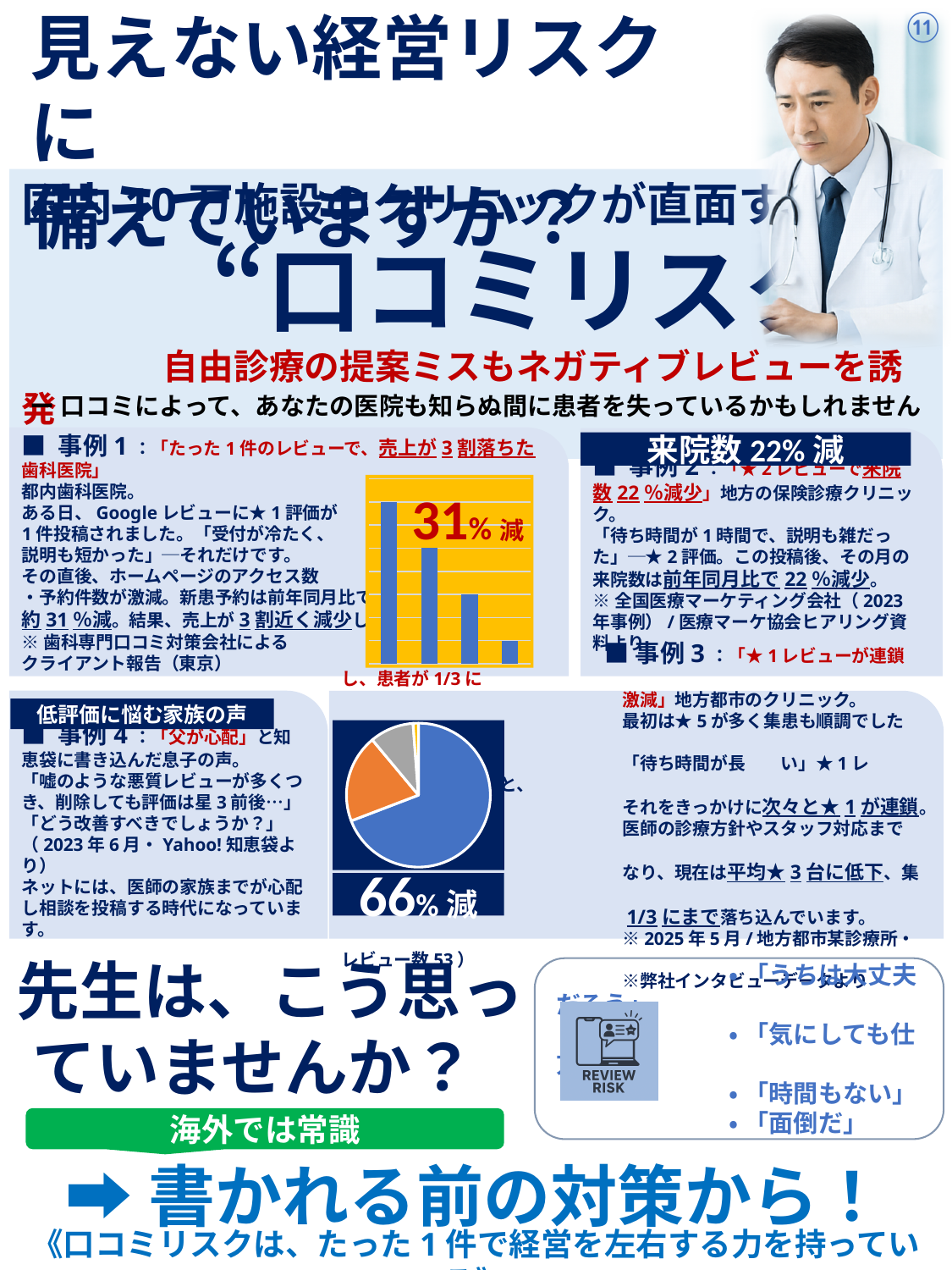
In the bar chart with the yellow background, do the bar values rise or fall from left to right? fall How many bars are plotted in the bar chart with the yellow background? 4 In the pie chart in the lower middle of the slide, is the orange slice larger or smaller than the gray slice? larger In the bar chart with the yellow background, which bar is the shortest? the rightmost bar In the bar chart with the yellow background, which bar is the tallest? the leftmost bar What kind of chart is the chart in the lower middle of the slide, above the "66% 減" label? pie chart How many slices does the pie chart in the lower middle of the slide have? 4 In the bar chart with the yellow background, is the leftmost bar taller or shorter than the rightmost bar? taller What kind of chart is the chart with the yellow background in the upper middle of the slide? bar chart In the pie chart in the lower middle of the slide, which colour slice is the smallest? yellow In the pie chart in the lower middle of the slide, which colour slice is the largest? blue What percentage label is printed over the bar chart with the yellow background? 31% 減